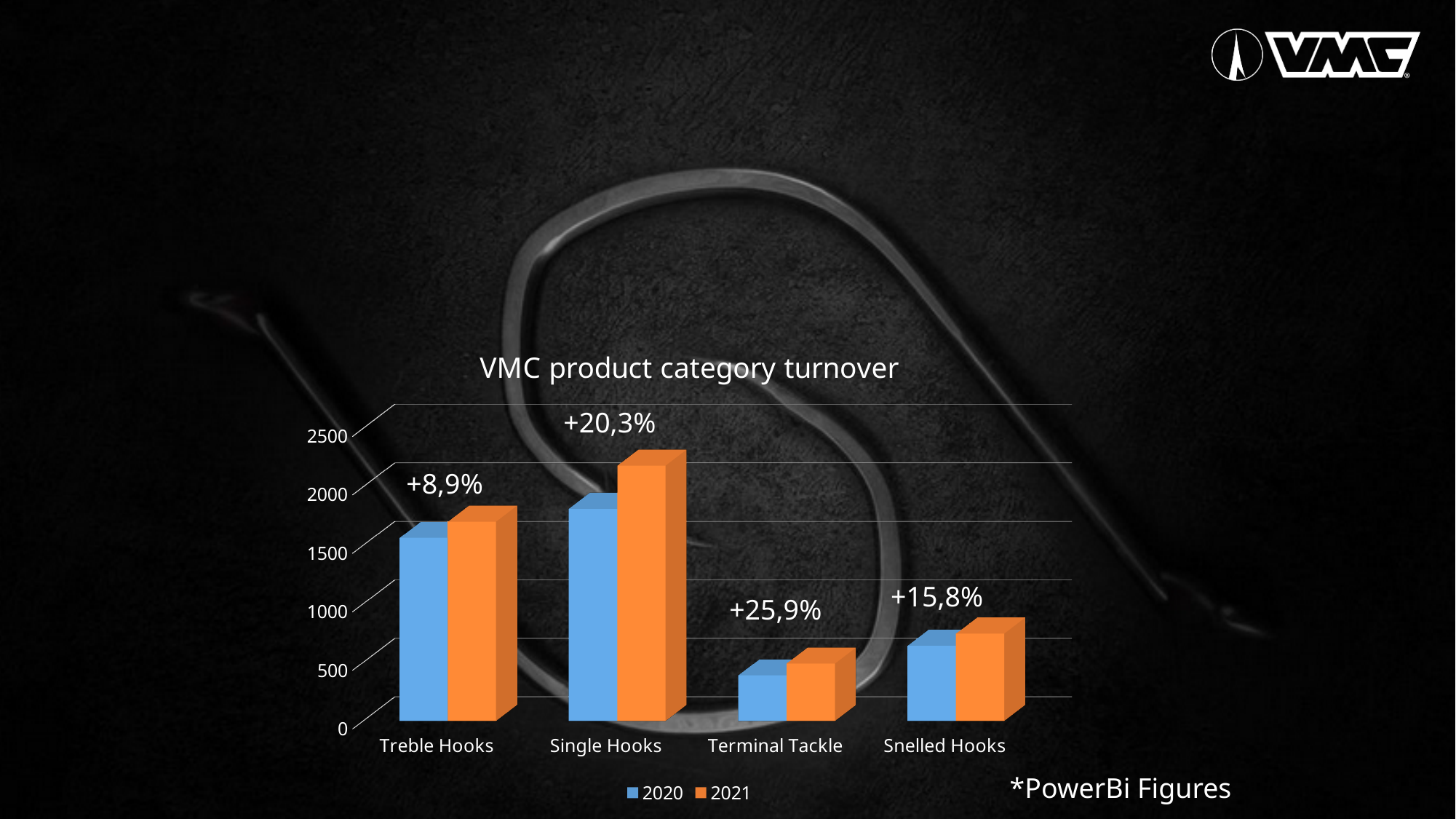
Which product category shows the largest printed percentage increase? Terminal Tackle What kind of chart is shown on the slide? Bar chart Which product category shows the smallest printed percentage increase? Treble Hooks What is the title of the chart? VMC product category turnover Is the 2021 value for Terminal Tackle greater or less than 1000? less Is the 2021 value for Single Hooks greater or less than 2000? greater What percentage change is printed above the Single Hooks bars? +20,3% How many series does the legend list? 2 Which product category has the highest turnover in 2021? Single Hooks Which product category has the lowest turnover in 2020? Terminal Tackle How many product categories are shown on the x axis? 4 What percentage change is printed above the Treble Hooks bars? +8,9%